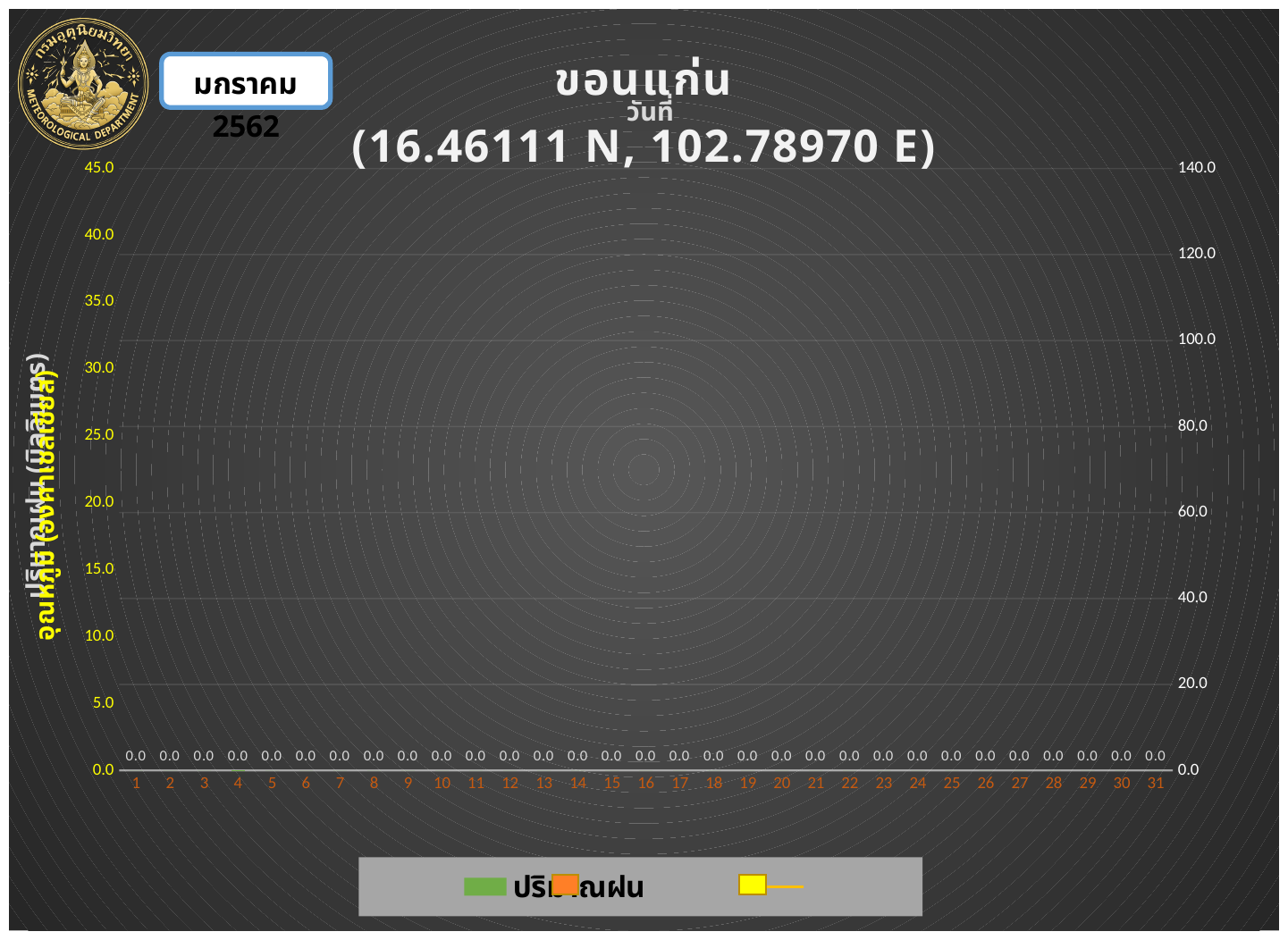
What station name is shown in the chart title? ขอนแก่น What is the value printed for day 1 on the chart? 0.0 What is the highest tick value shown on the right vertical axis? 140.0 What is the difference between the values printed for day 10 and day 20? 0.0 What is the highest tick value shown on the left vertical axis? 45.0 What is the value printed for day 31 on the chart? 0.0 Is the value for day 25 greater or less than 20.0 on the right axis? less How many days (categories) are shown along the x axis of the chart? 31 Do the printed values rise, fall, or stay the same from day 1 to day 31? stay the same What is the value printed for day 15 on the chart? 0.0